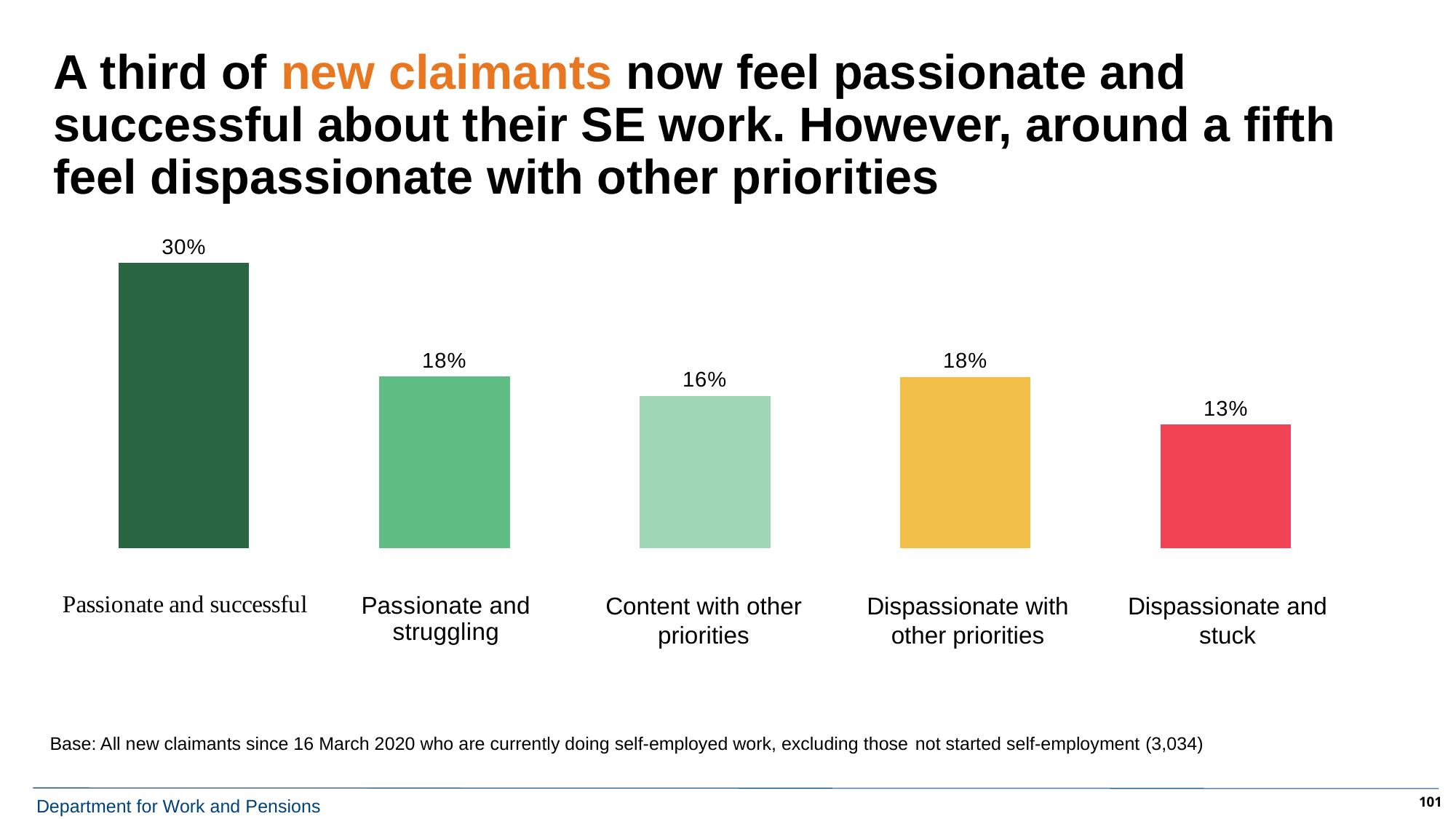
What is the difference between 'Passionate and successful' and 'Dispassionate and stuck'? 17 percentage points How many categories are shown in the chart? 5 What is the value for 'Passionate and struggling'? 18% What colour is the bar for 'Dispassionate and stuck'? Red What is the value for 'Dispassionate and stuck'? 13% What is the value for 'Content with other priorities'? 16% Which is larger: 'Content with other priorities' or 'Dispassionate with other priorities'? Dispassionate with other priorities What percentage of new claimants feel passionate and successful? 30% What type of chart is shown on the slide? Bar chart Which category has the lowest value? Dispassionate and stuck Which category has the highest value? Passionate and successful What is the difference between 'Dispassionate with other priorities' and 'Content with other priorities'? 2 percentage points